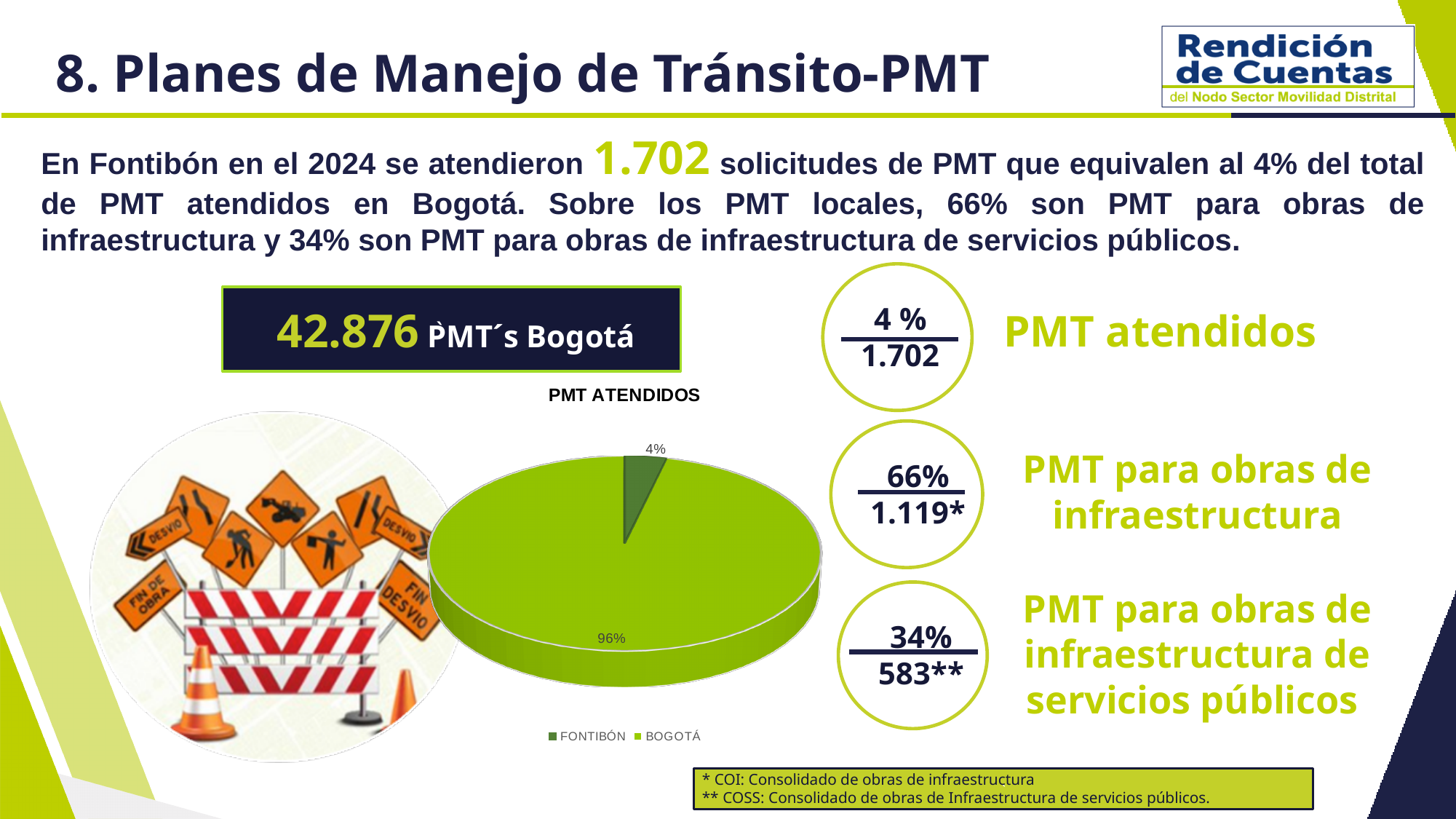
What is the title of the pie chart? PMT ATENDIDOS Which slice of the pie chart is the smallest? FONTIBÓN Which legend entry of the pie chart is shown in dark green? FONTIBÓN What share of the pie chart does BOGOTÁ represent? 96% What share of the pie chart does FONTIBÓN represent? 4% How many entries does the legend of the pie chart list? 2 What is the difference in percentage points between the BOGOTÁ and FONTIBÓN slices? 92% What type of chart is shown on the slide? pie chart Which is larger in the pie chart, FONTIBÓN or BOGOTÁ? BOGOTÁ How many slices does the pie chart have? 2 Which slice of the pie chart is the largest? BOGOTÁ